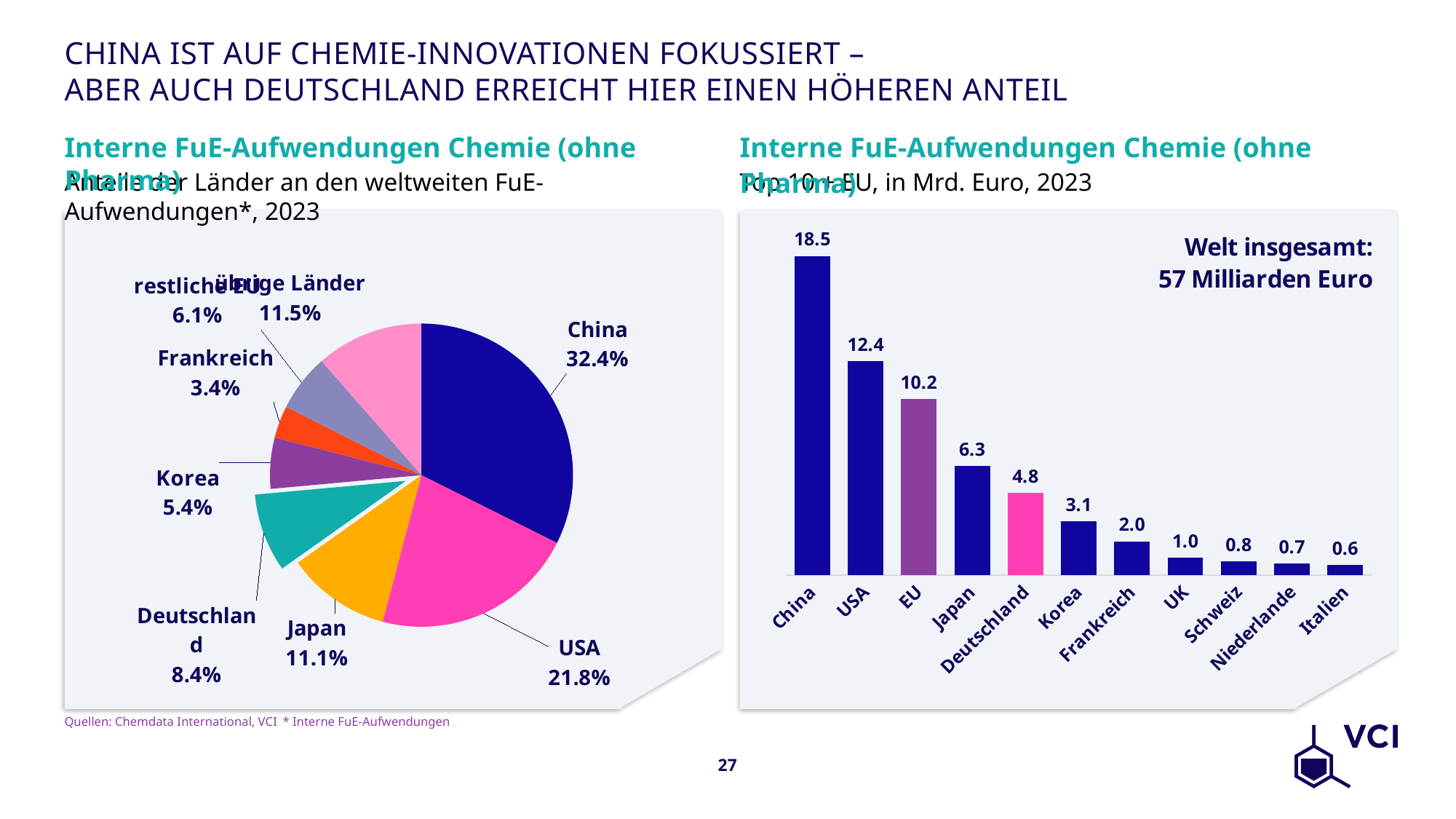
In the bar chart on the right, which is larger: the value for Japan or the value for EU? EU In the pie chart on the left, what share does Deutschland have? 8.4% In the bar chart on the right, how many bars are shown? 11 In the bar chart on the right, which country has the lowest value? Italien In the pie chart on the left, which of the labelled slices is the smallest? Frankreich In the bar chart on the right, what is the difference between the values for China and USA? 6.1 In the bar chart on the right, what is the value for Deutschland? 4.8 What kind of chart is shown on the left side of the slide? Pie chart In the bar chart on the right, what is the value for Korea? 3.1 In the pie chart on the left, what share does China have? 32.4% In the pie chart on the left, which country has the largest slice? China In the pie chart on the left, how many percentage points larger is the USA share than the Japan share? 10.7